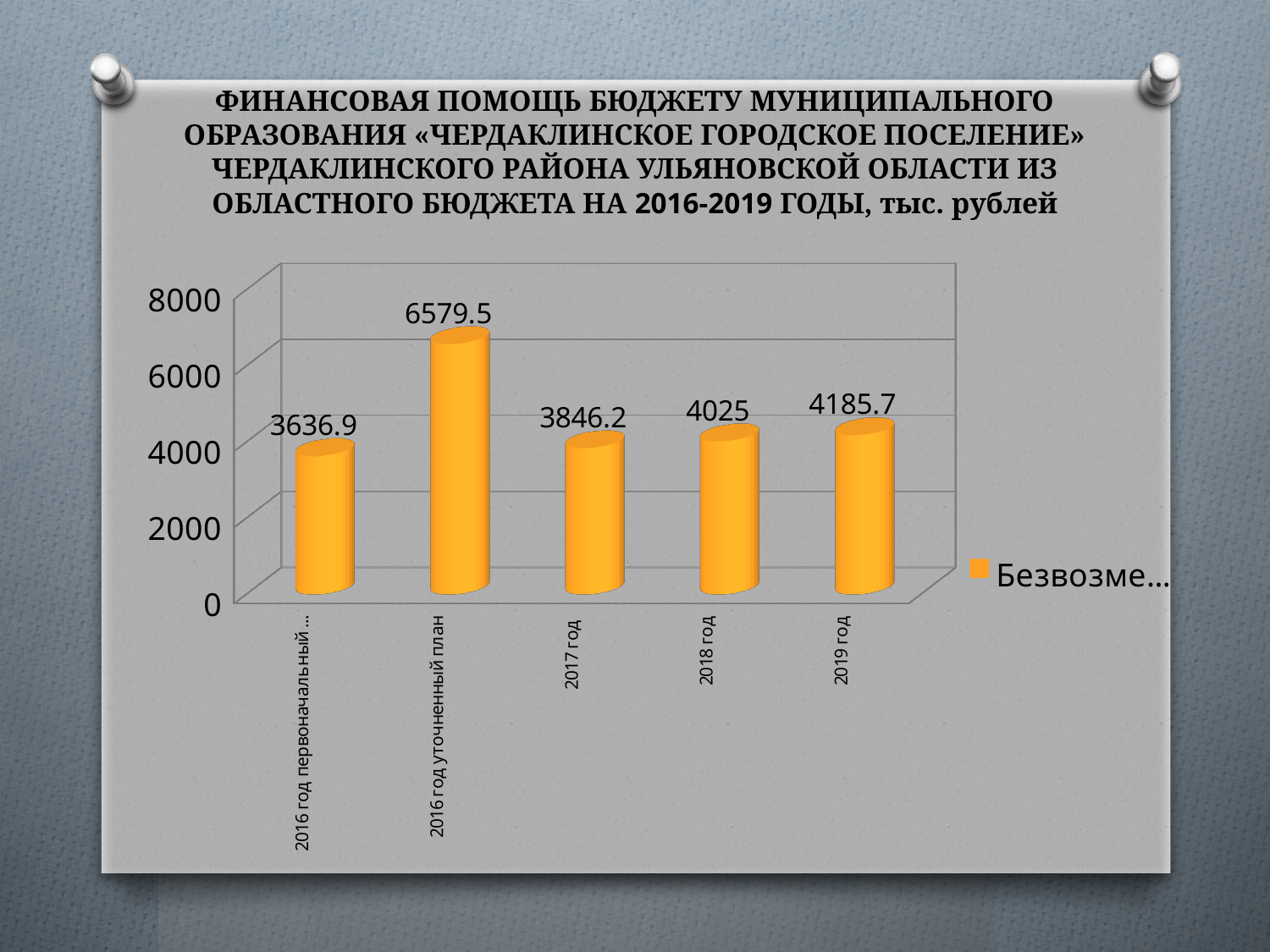
What is the value for 2018 год? 4025 What is the value of the leftmost bar (2016 год первоначальный ...)? 3636.9 How many bars are shown in the chart? 5 Which is larger, the value for 2018 год or for 2017 год? 2018 год What is the value for 2016 год уточненный план? 6579.5 What is the difference between the values for 2019 год and 2018 год? 160.7 What is the difference between the values for 2016 год уточненный план and 2017 год? 2733.3 What is the value for 2019 год? 4185.7 What is the value for 2017 год? 3846.2 Which category has the highest value? 2016 год уточненный план What kind of chart is shown on the slide? Bar chart Do the values rise or fall from 2017 год to 2019 год? Rise